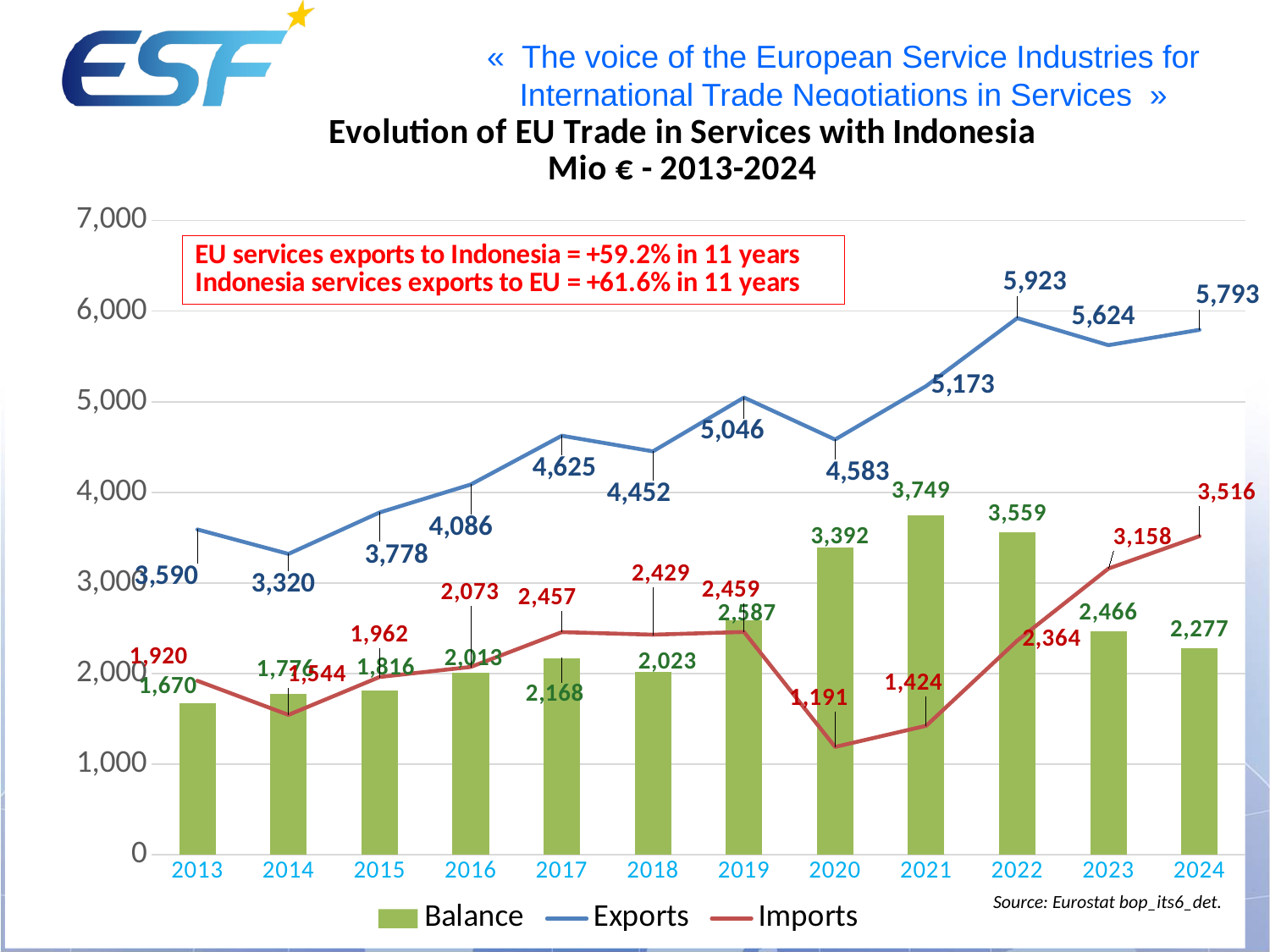
In which year were Exports highest? 2022 What was the Balance in 2021? 3,749 In which year was the Balance lowest? 2013 What was the value of Exports in 2022? 5,923 Which series is shown as green bars? Balance What was the value of Imports in 2020? 1,191 What is the difference between Exports and Imports in 2024? 2,277 What kind of chart is this? Combined bar and line chart How many series does the legend list? 3 How many years are shown on the x axis? 12 Which was larger in 2023: the Balance or Imports? Imports In which year were Imports lowest? 2020